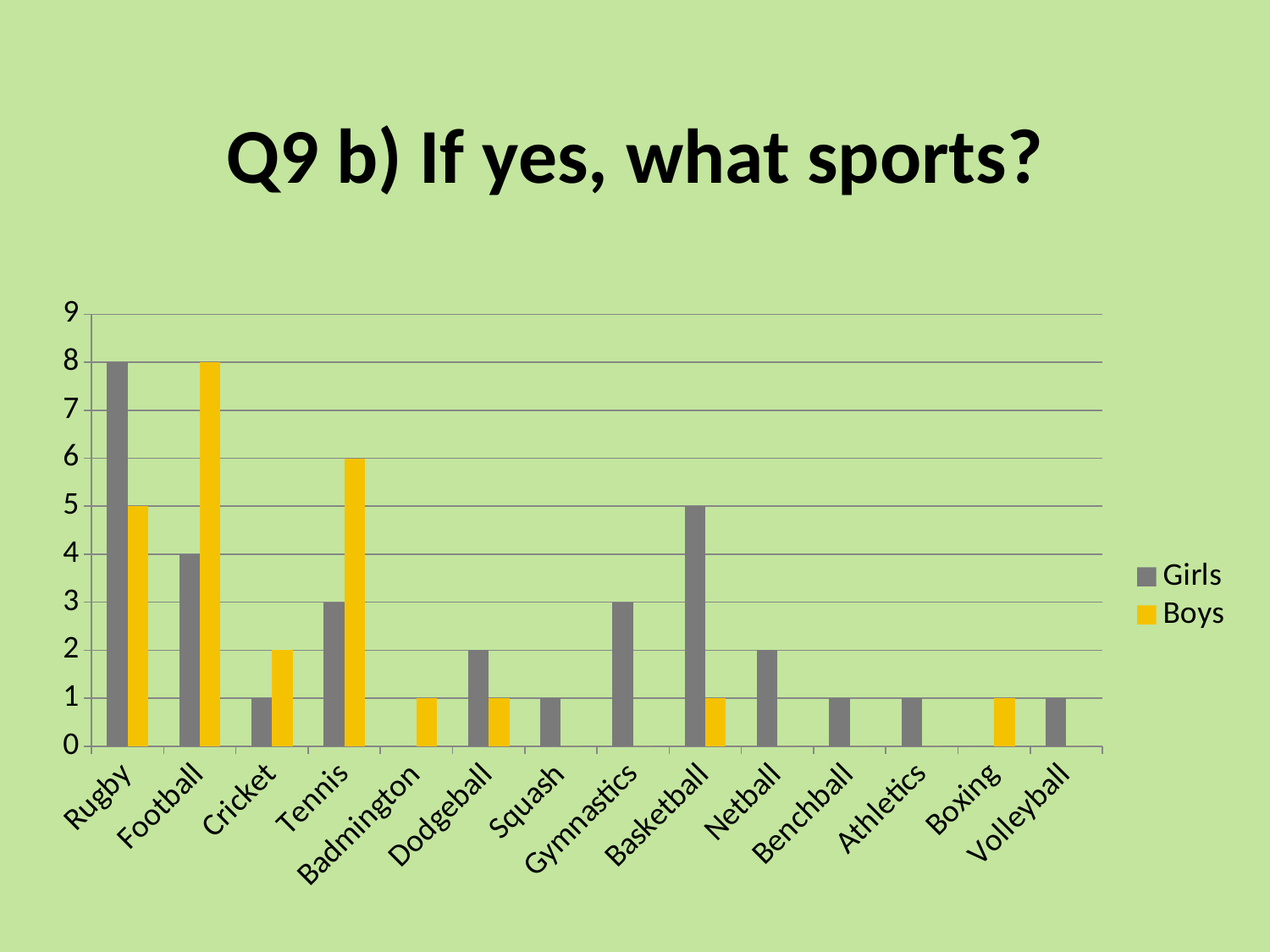
What is the value for Girls for Rugby? 8 Is the value for Boys for Tennis greater or less than 5? greater What is the difference between the Boys and Girls values for Football? 4 How many sports categories are shown on the x axis? 14 What is the value for Girls for Basketball? 5 What type of chart is shown on the slide? bar chart Which is larger for Rugby, the Girls value or the Boys value? Girls What is the value for Boys for Tennis? 6 What is the title of the chart's slide? Q9 b) If yes, what sports? How many series does the legend list? 2 Which sport has the highest value for Boys? Football Which sport has the highest value for Girls? Rugby